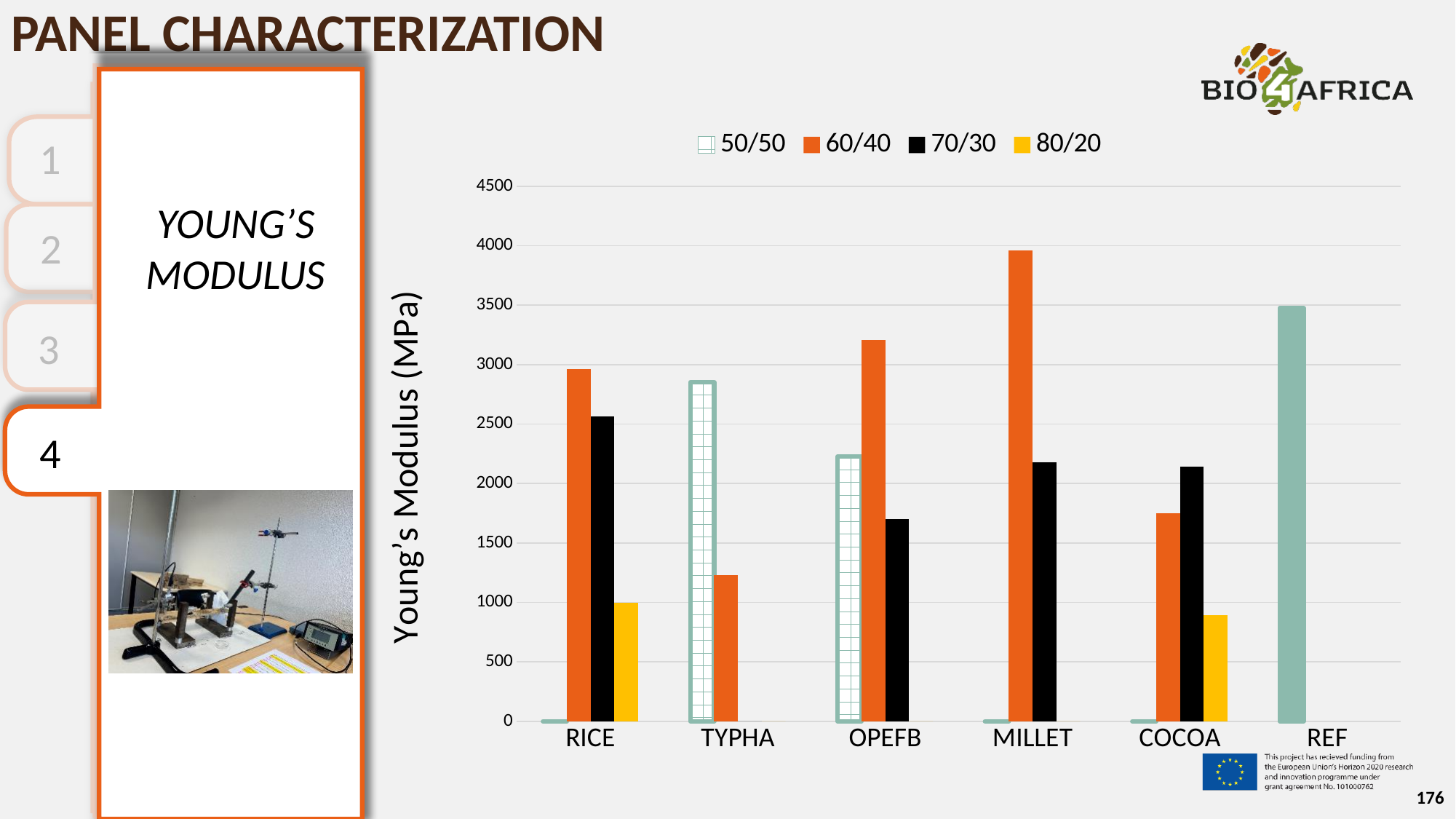
Is the 60/40 value for MILLET greater or less than 3500? greater Which category has the lowest 60/40 value? TYPHA What is the label of the y axis of the chart? Young's Modulus (MPa) How many series does the chart legend list? 4 Is the value for REF greater or less than 3000? greater For COCOA, which is larger: the 60/40 value or the 70/30 value? 70/30 How many categories are shown on the x axis of the chart? 6 Is the 80/20 value for RICE greater or less than 1500? less For OPEFB, which is larger: the 60/40 value or the 70/30 value? 60/40 Which category has the highest 60/40 value? MILLET What kind of chart is shown on the slide? bar chart